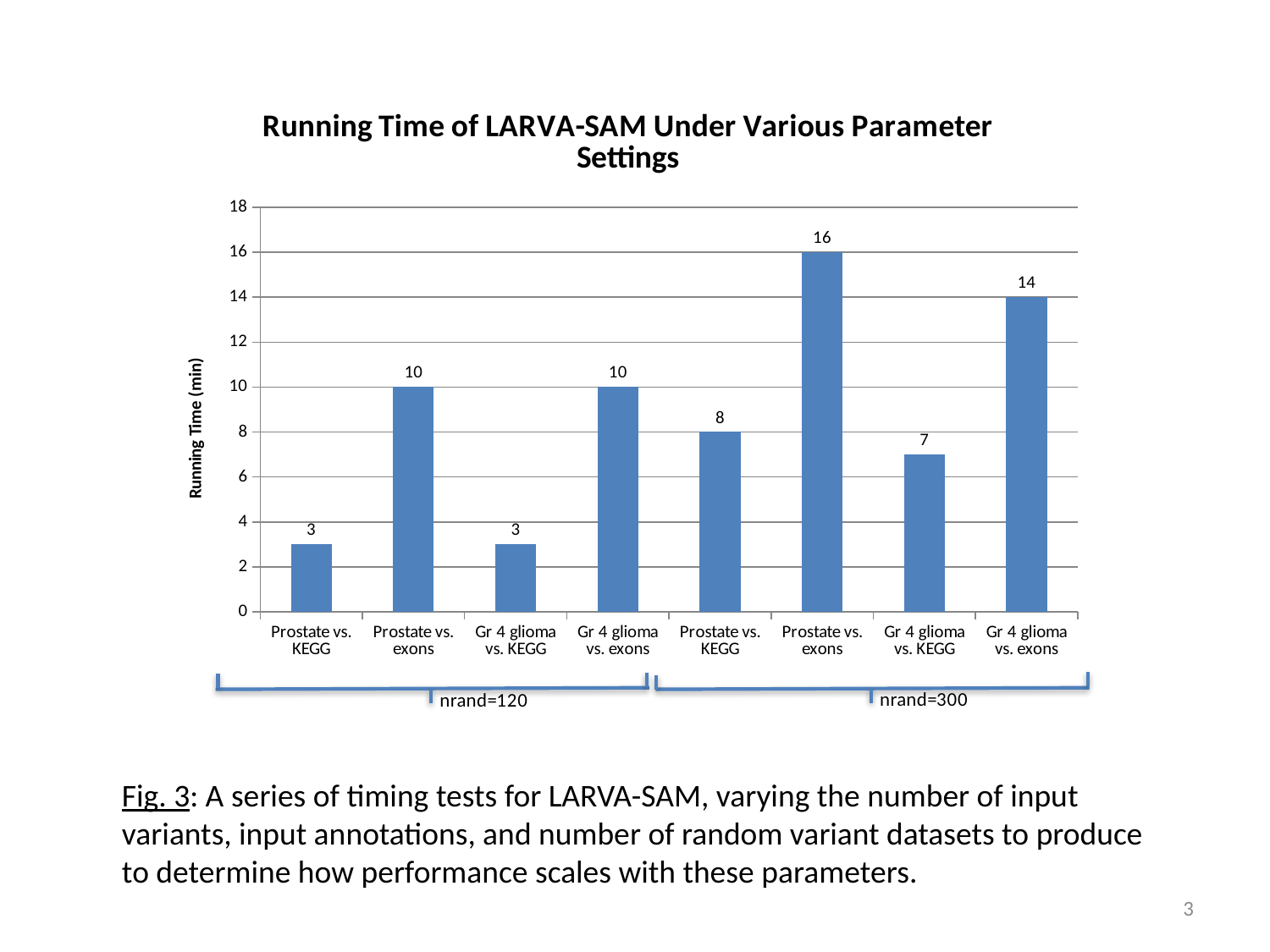
Which bar has the highest running time? Prostate vs. exons (nrand=300) What is the running time for Gr 4 glioma vs. exons under nrand=300? 14 How many bars are plotted on the chart? 8 What is the title of the chart? Running Time of LARVA-SAM Under Various Parameter Settings What is the running time for Gr 4 glioma vs. KEGG under nrand=120? 3 Which is larger: the running time for Prostate vs. KEGG at nrand=300 or Gr 4 glioma vs. KEGG at nrand=300? Prostate vs. KEGG at nrand=300 What is the running time for Prostate vs. exons under nrand=300? 16 What is the difference in running time between Prostate vs. exons at nrand=300 and Prostate vs. exons at nrand=120? 6 What type of chart is shown on the slide? Bar chart Is the running time for Gr 4 glioma vs. exons under nrand=300 greater or less than 12? greater What is the label of the y-axis? Running Time (min) What is the lowest running time shown on the chart? 3